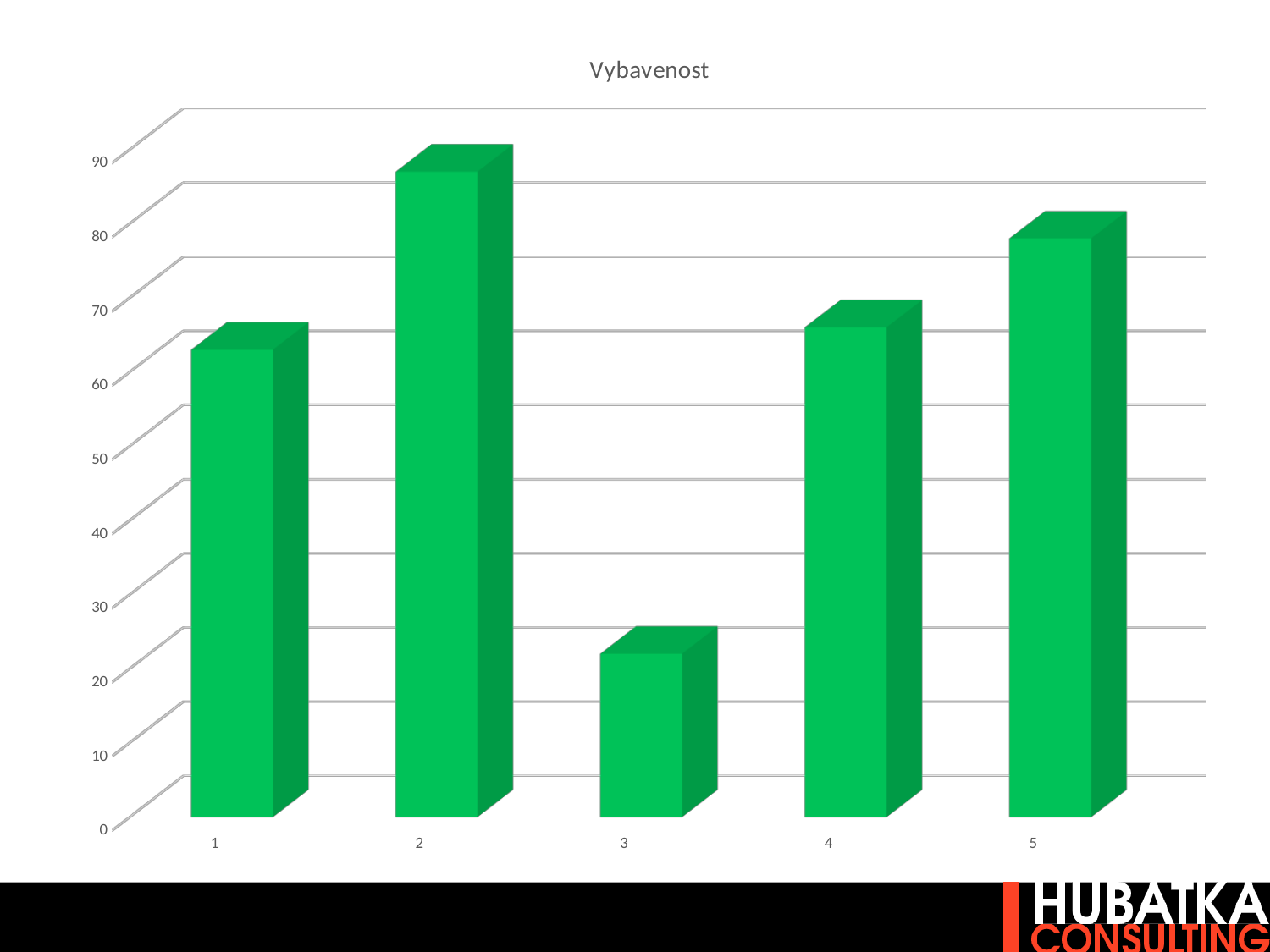
What colour are the bars in the chart? green Which is larger, the value for category 2 or category 5? 2 What is the title of the chart? Vybavenost Is the value for category 1 greater or less than 50? greater Which is larger, the value for category 1 or category 3? 1 What kind of chart is shown on the slide? bar chart How many categories are shown on the x axis of the chart? 5 Is the value for category 5 greater or less than 70? greater Is the value for category 3 greater or less than 30? less Which category has the lowest bar? 3 Which category has the highest bar? 2